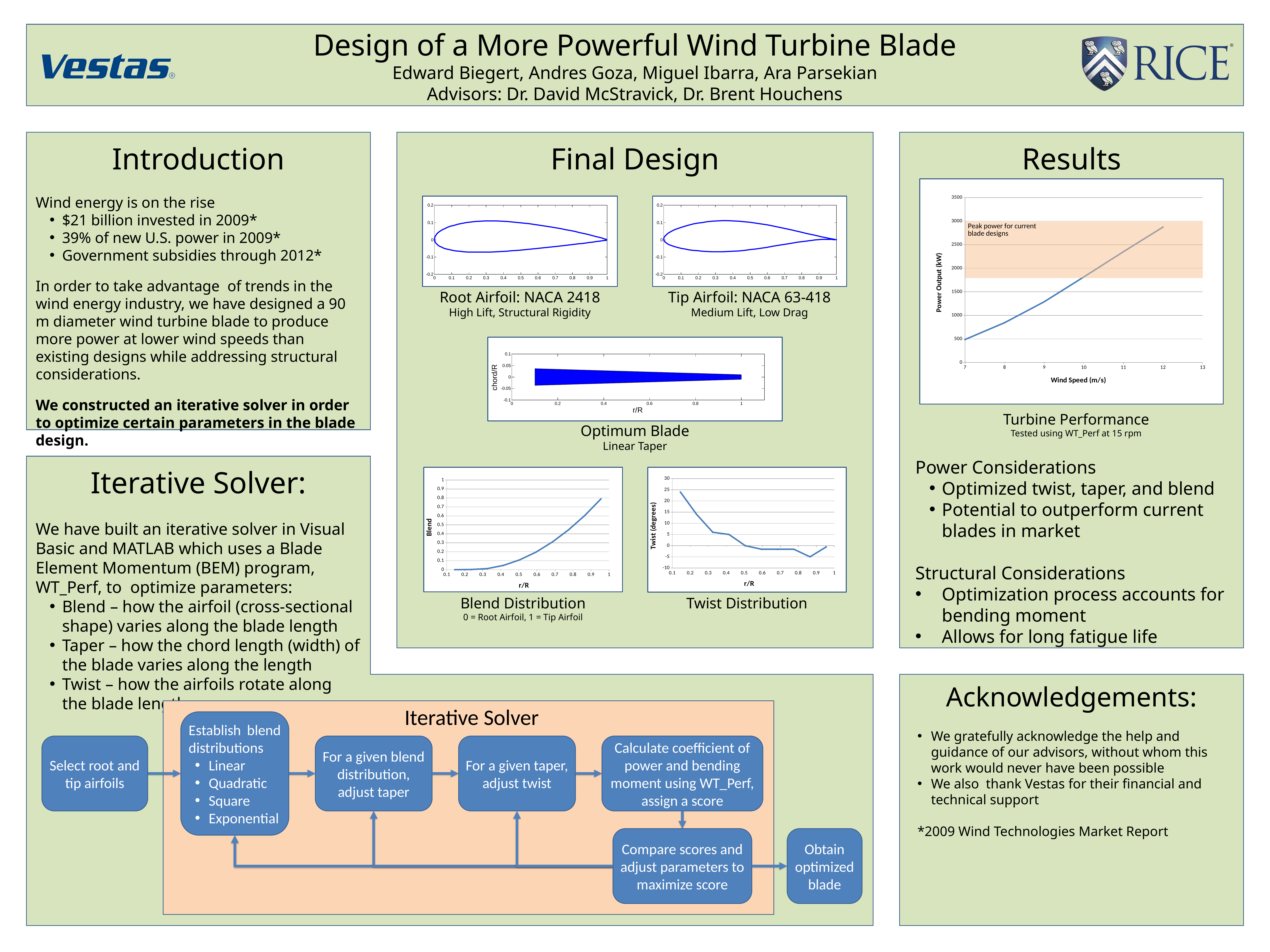
In the Twist Distribution chart, which has the larger twist value: r/R = 0.15 or r/R = 0.9? r/R = 0.15 What is the y-axis label of the Turbine Performance chart? Power Output (kW) In the Turbine Performance chart, does power output rise or fall as wind speed increases? rises What is the x-axis label of the Turbine Performance chart? Wind Speed (m/s) In the Turbine Performance chart, is the power output at a wind speed of 12 m/s greater or less than 2500 kW? greater In the Blend Distribution chart, does the blend value rise or fall as r/R increases? rises In the Turbine Performance chart, is the power output at a wind speed of 9 m/s greater or less than 1500 kW? less In the Blend Distribution chart, is the blend value at r/R = 0.9 greater or less than 0.5? greater What kind of chart is the Turbine Performance chart in the Results section? line chart